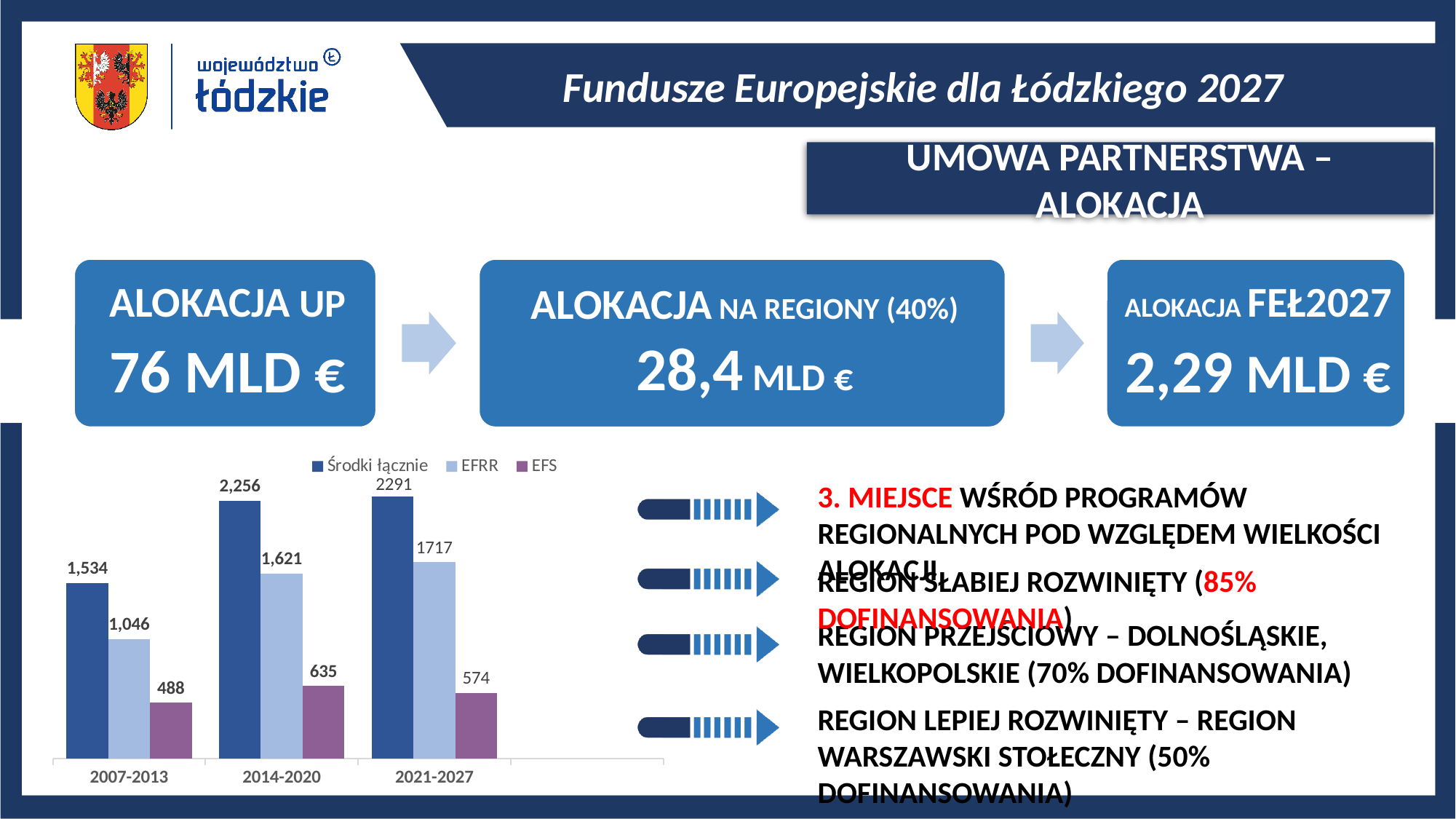
Which period has the lowest EFS value? 2007-2013 What type of chart is shown on the slide? bar chart What is the difference between the EFRR values for 2021-2027 and 2014-2020? 96 Which is larger: EFRR for 2007-2013 or EFS for 2014-2020? EFRR for 2007-2013 What is the value of Środki łącznie for 2007-2013? 1,534 Which period has the highest EFS value? 2014-2020 What is the value of EFS for 2021-2027? 574 How many series does the chart legend list? 3 Does the EFRR value rise or fall from 2007-2013 to 2021-2027? rise What is the value of EFRR for 2014-2020? 1,621 What is the value of Środki łącznie for 2021-2027? 2291 How many period categories are shown on the x axis of the chart? 3